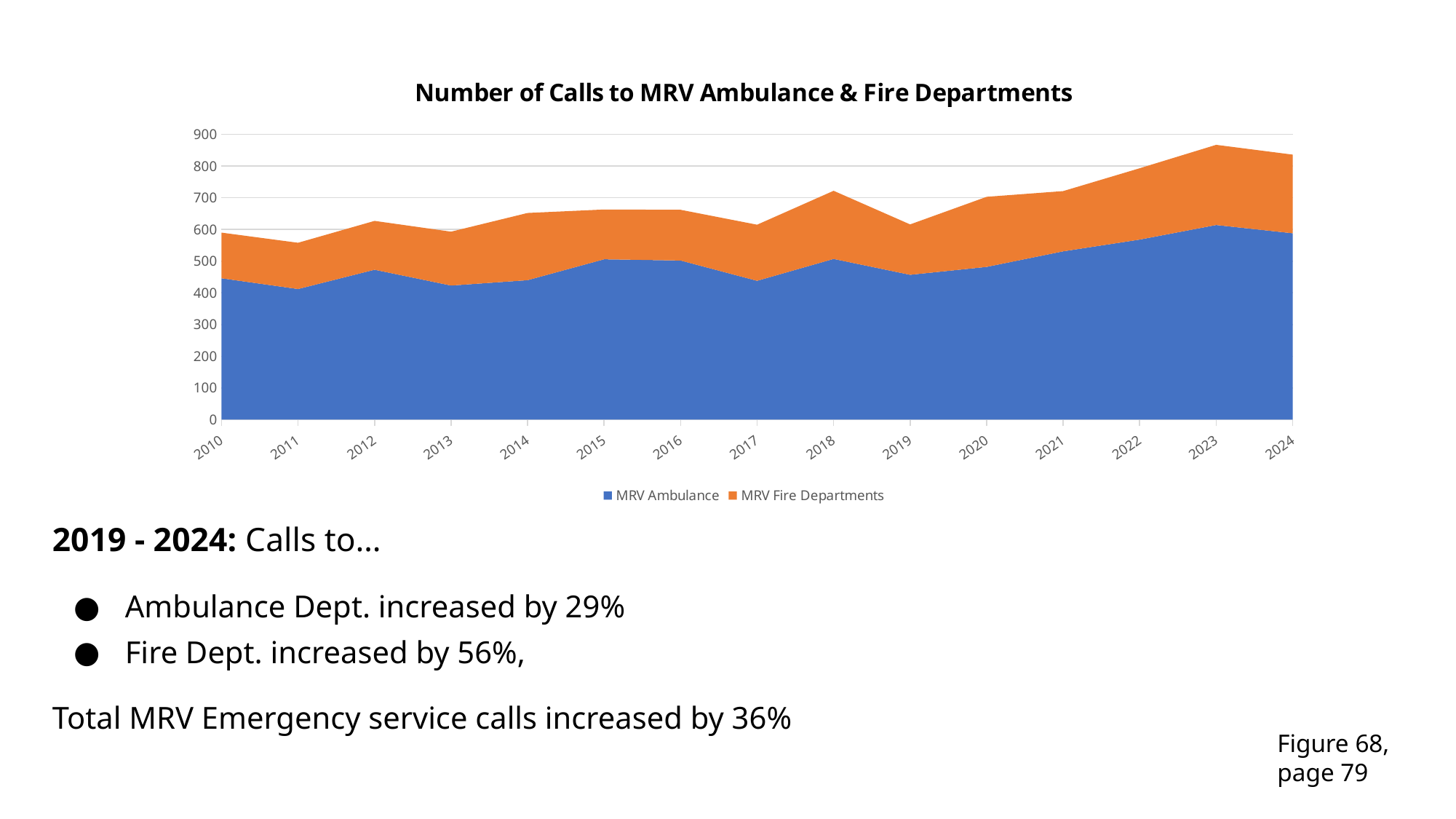
Do the MRV Ambulance values rise or fall from 2019 to 2024? rise What is the title of the chart? Number of Calls to MRV Ambulance & Fire Departments How many series does the chart's legend list? 2 In which year is the total number of calls (ambulance plus fire) highest? 2023 Is the total number of calls in 2023 greater or less than 800? greater Which year has the larger MRV Ambulance value, 2015 or 2017? 2015 Which series is shown in orange in the chart? MRV Fire Departments Is the value for MRV Ambulance in 2011 greater or less than 500? less How many years are plotted along the x axis of the chart? 15 Is the value for MRV Ambulance in 2024 greater or less than 500? greater What kind of chart is shown on the slide? Stacked area chart In which year is the total number of calls (ambulance plus fire) lowest? 2011